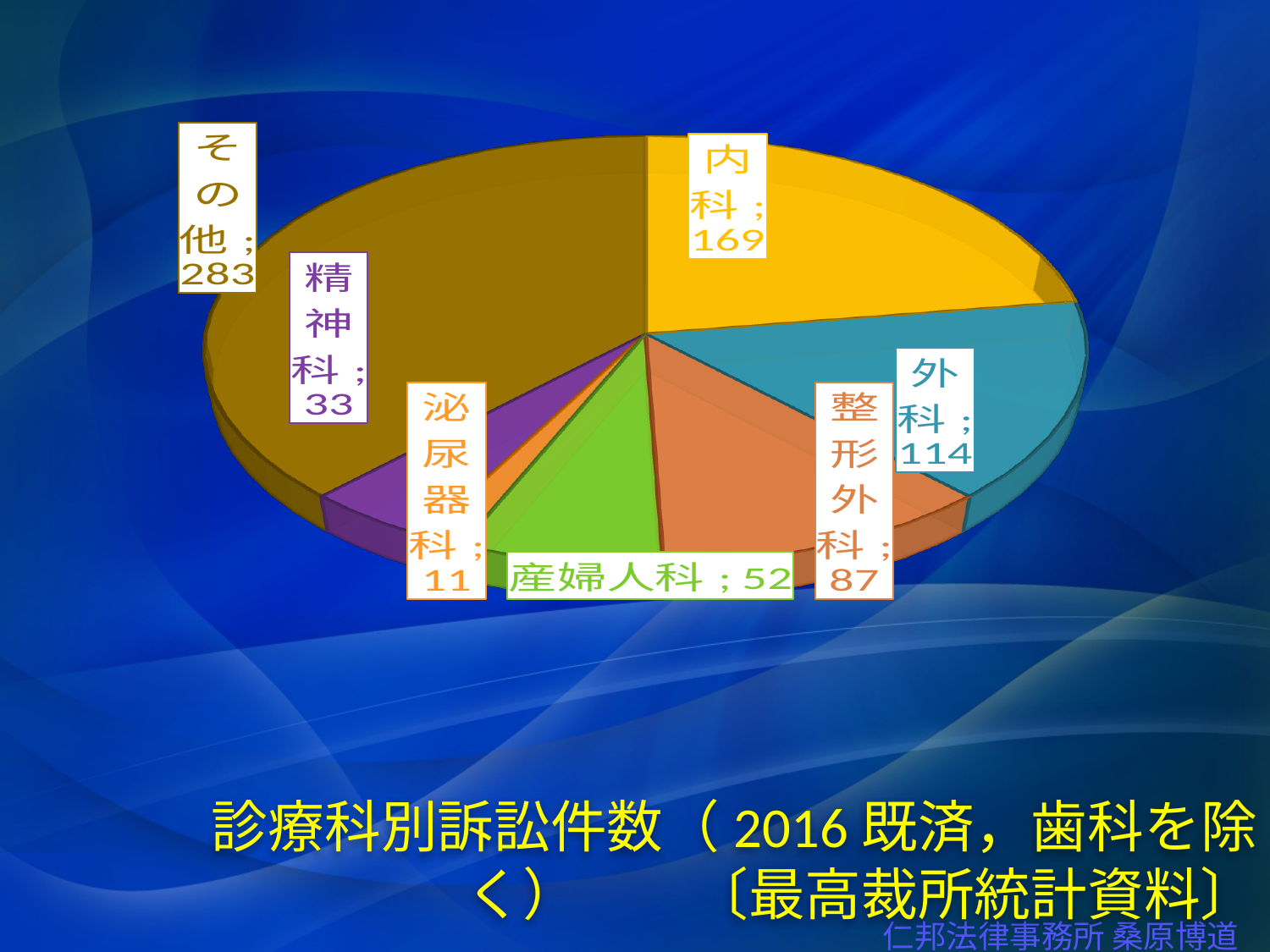
What is the value for 内科? 169 Which is larger, 精神科 or 産婦人科? 産婦人科 What is the value for 産婦人科? 52 What type of chart is shown on the slide? Pie chart What is the value for 整形外科? 87 What is the value for 外科? 114 Which category has the largest value? その他 What is the title of the chart? 診療科別訴訟件数（2016既済，歯科を除く）〔最高裁所統計資料〕 What is the value for 泌尿器科? 11 How many slices does the pie chart have? 7 Which category has the smallest value? 泌尿器科 What is the difference between the values for 内科 and 外科? 55